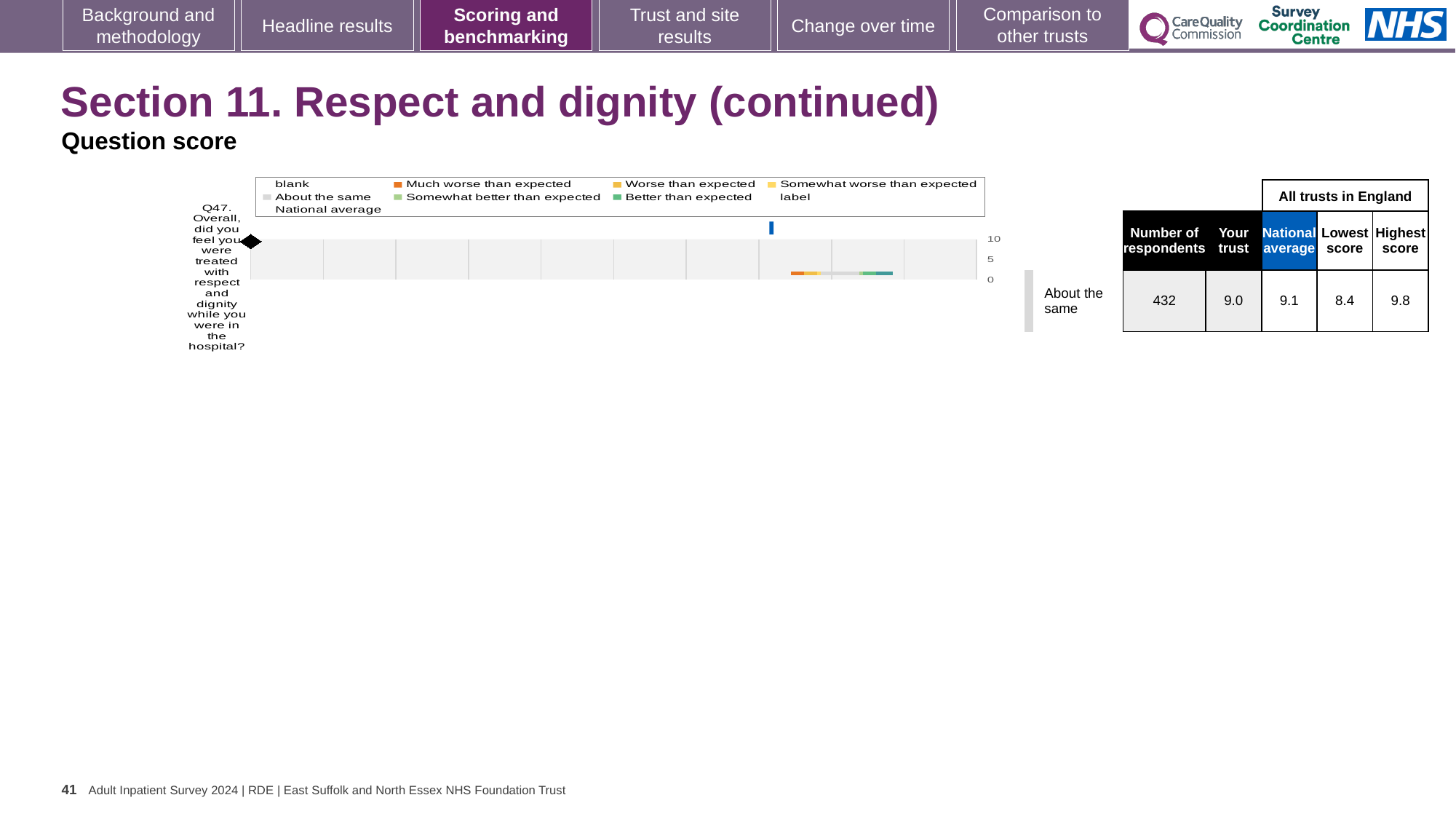
For Q47, which is larger: the 'Your trust' score or the national average? National average According to the table beside the chart, how many respondents answered Q47? 432 What kind of chart is shown for Q47 on this slide? bar chart According to the table beside the chart, what is the lowest score among all trusts in England for Q47? 8.4 According to the table beside the chart, what is the highest score among all trusts in England for Q47? 9.8 According to the table beside the chart, what is the 'Your trust' score for Q47? 9.0 For Q47, what is the difference between the highest score and the lowest score among all trusts in England? 1.4 What is the highest tick value shown on the chart's score axis? 10 What benchmark category label is shown next to the chart for Q47? About the same According to the table beside the chart, what is the national average score for Q47? 9.1 How many survey questions are plotted in the chart on this slide? 1 How many entries does the chart's legend list? 9